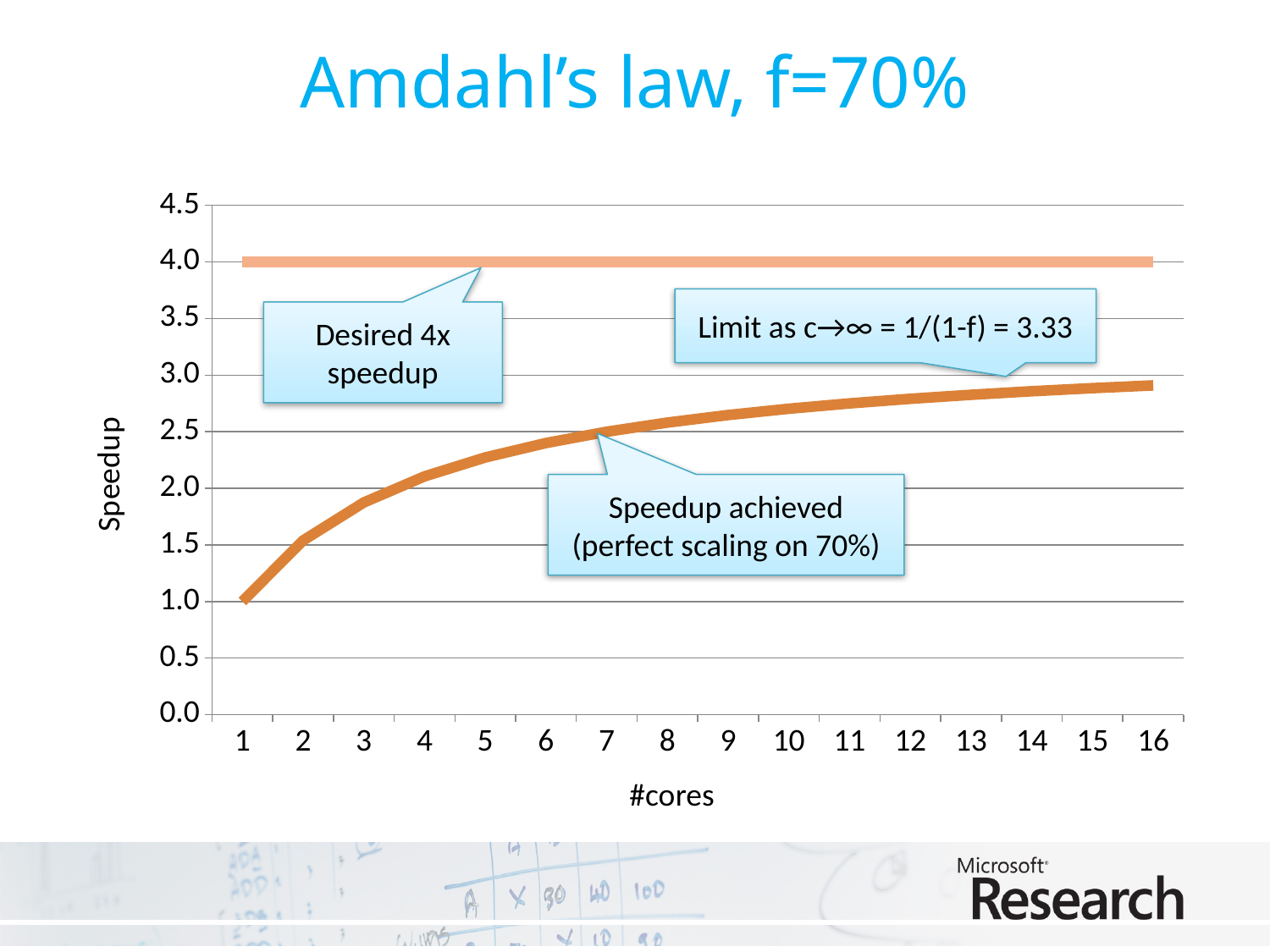
Does the speedup achieved rise or fall as the number of cores increases? rises Is the speedup achieved at 3 cores greater or less than 2.0? less At 16 cores, which is higher: the desired speedup line or the speedup achieved curve? desired speedup line What is the speedup achieved at 1 core? 1.0 At which number of cores is the speedup achieved lowest? 1 What speedup value does the flat 'Desired 4x speedup' line sit at? 4.0 Is the speedup achieved at 16 cores greater or less than 2.5? greater What is the label of the x axis? #cores How many core counts are plotted along the x axis? 16 What is the title of the chart? Amdahl's law, f=70% What kind of chart is shown on the slide? line chart Is the speedup achieved at 16 cores greater or less than 3.0? less